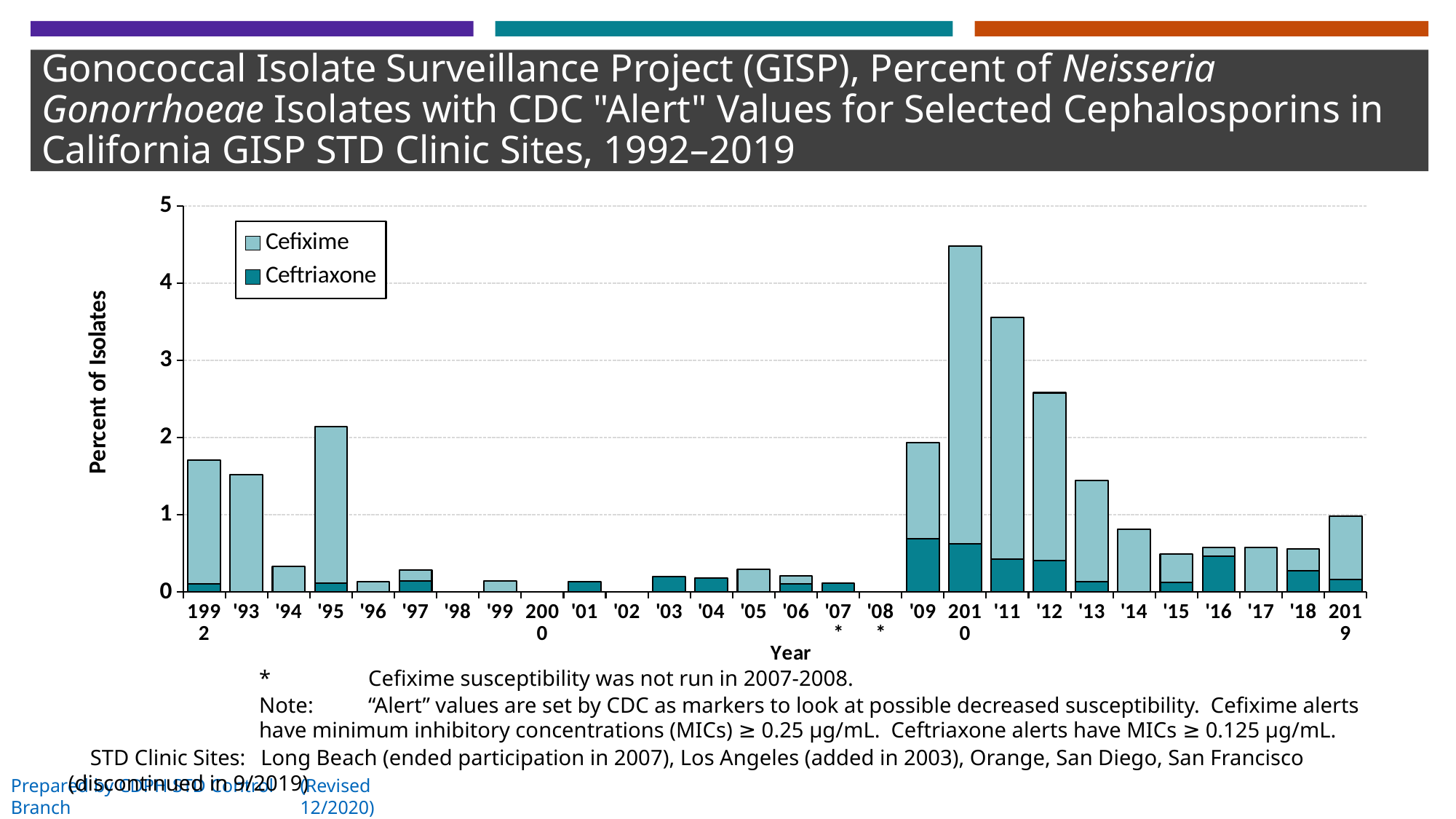
How many series does the legend list? 2 Do the total values rise or fall from 2010 to 2015? fall Is the total value for 1995 greater or less than 2? greater Which year has the highest total percent of isolates with alert values? 2010 What kind of chart is shown on the slide? Stacked bar chart Is the total value for 2010 greater or less than 4? greater How many years are shown along the x axis? 28 Which year has the larger total bar, 2010 or 2011? 2010 Which two series are listed in the legend? Cefixime and Ceftriaxone Is the total value for 2014 greater or less than 1? less What is the label on the y axis? Percent of Isolates